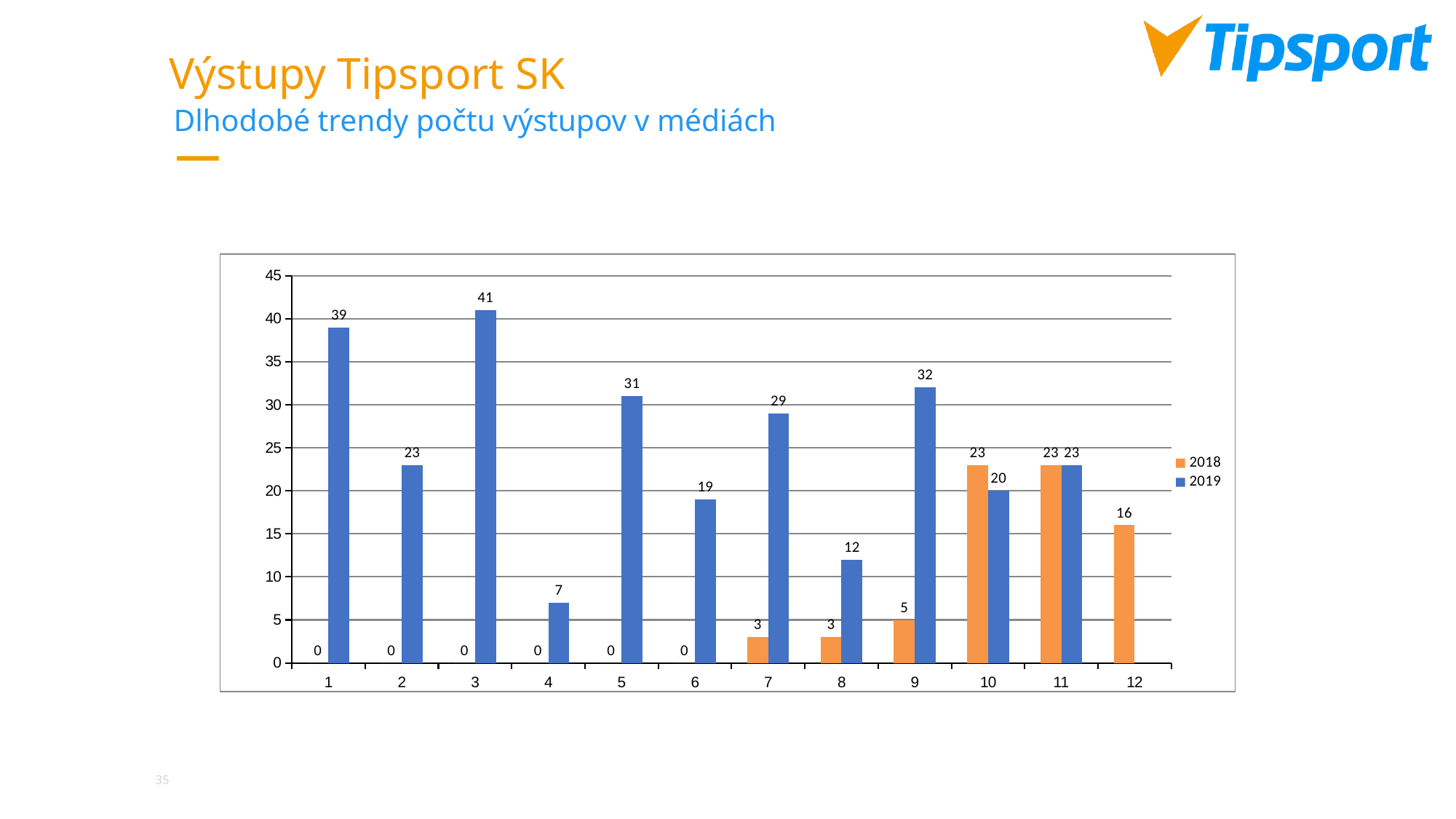
Do the 2018 values rise or fall from category 9 to category 10? Rise What is the difference between the 2018 and 2019 values in category 10? 3 Which series is shown in orange in the legend? 2018 Which category has the lowest non-zero value for the 2018 series? 7 and 8 (both 3) What is the value for 2019 in category 6? 19 Which is larger in category 9: the 2018 value or the 2019 value? 2019 What kind of chart is shown on the slide? Bar chart What is the value for 2018 in category 12? 16 Which category has the highest value for the 2019 series? 3 What is the value for 2019 in category 3? 41 How many series does the legend list? 2 How many categories are shown on the x axis? 12